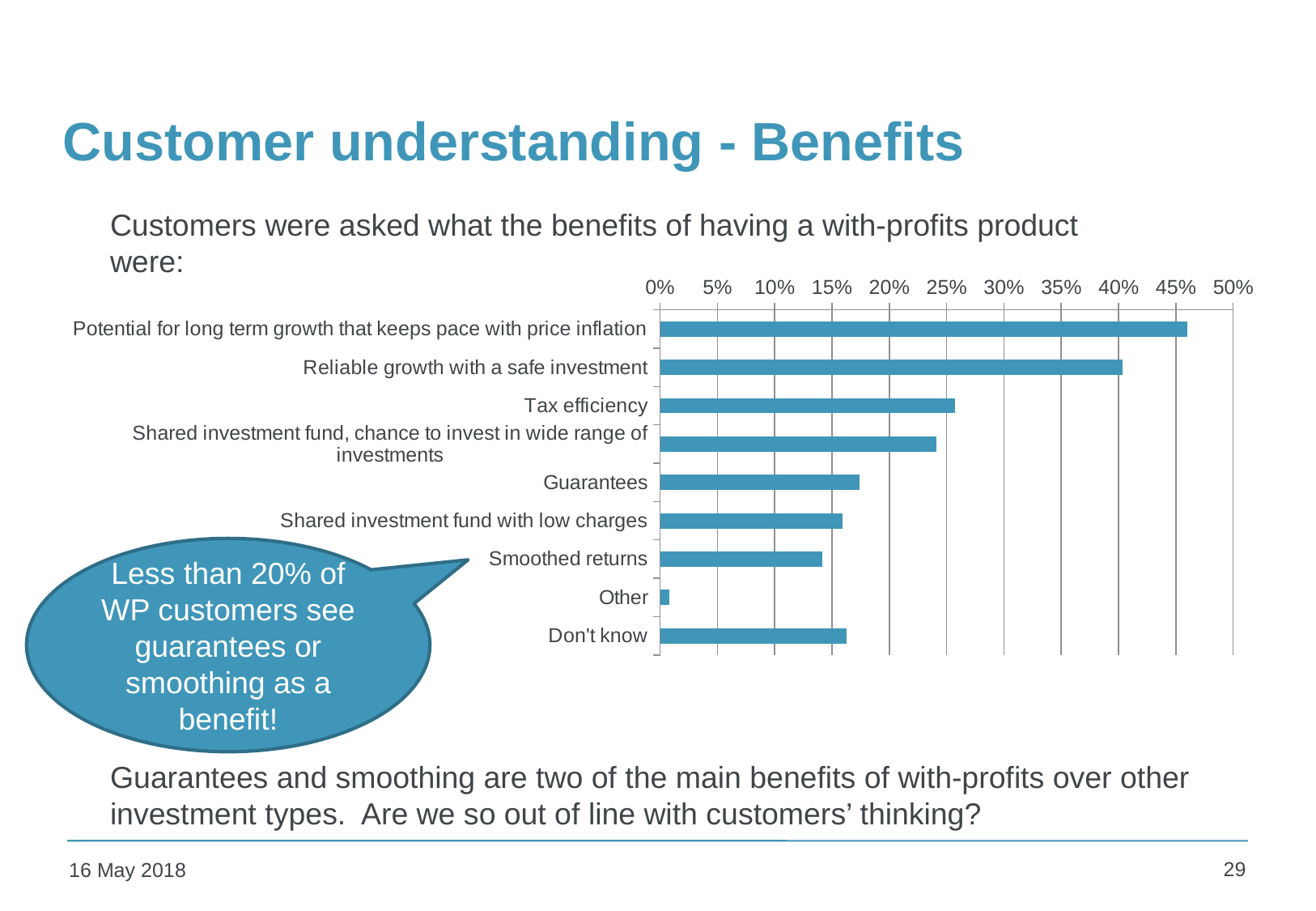
Which category has the lowest value in the chart? Other Is the value for 'Reliable growth with a safe investment' greater or less than 35%? greater Which is larger, the value for 'Tax efficiency' or the value for 'Guarantees'? Tax efficiency What is the highest percentage shown on the chart's axis? 50% How many categories (benefits) are plotted in the chart? 9 Which benefit has the highest value in the chart? Potential for long term growth that keeps pace with price inflation Is the value for 'Smoothed returns' greater or less than 10%? greater Is the value for 'Tax efficiency' greater or less than 30%? less What kind of chart is shown on the slide? bar chart